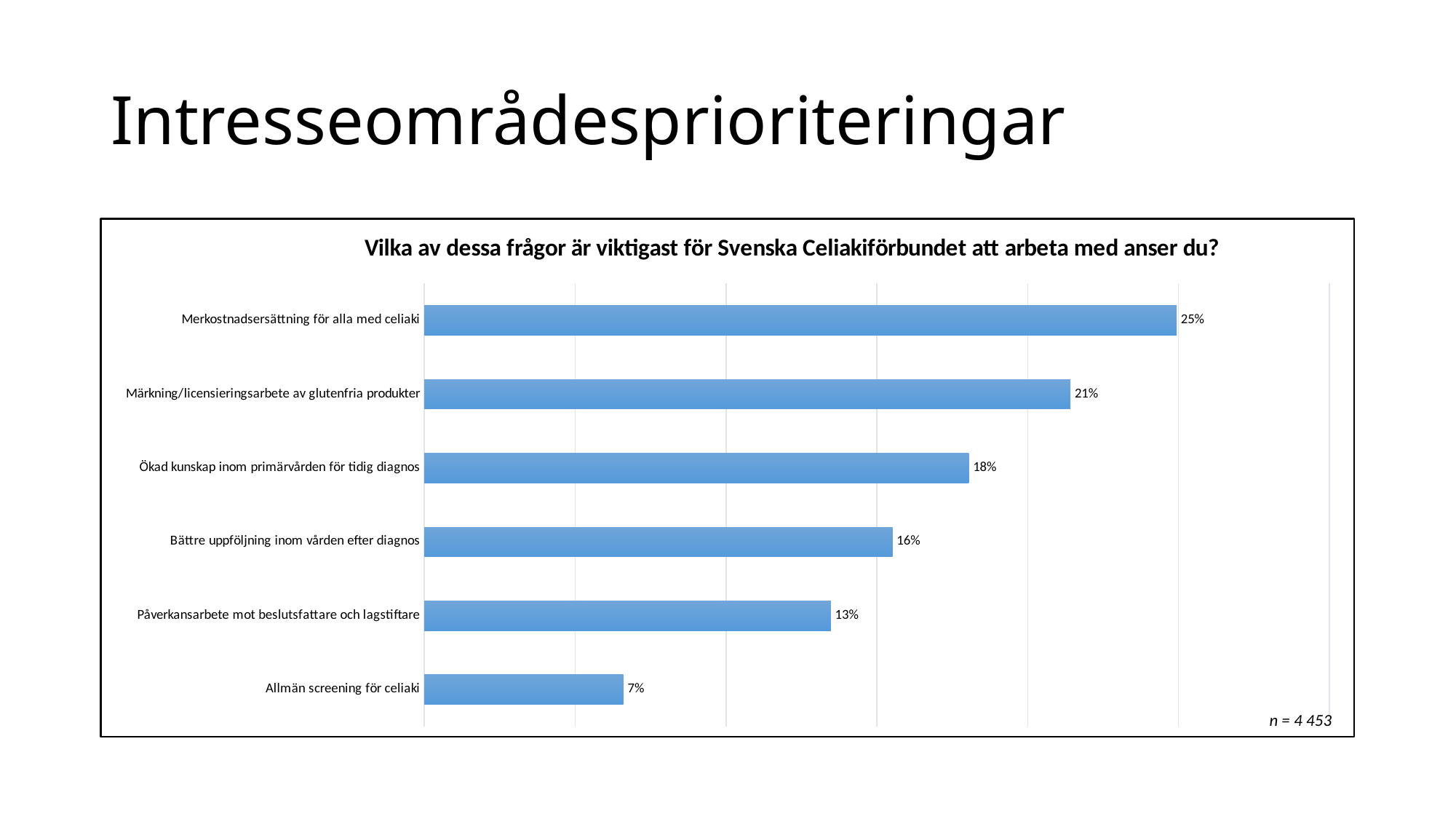
Which category has the lowest value? Allmän screening för celiaki What sample size (n) is noted on the chart? n = 4 453 What value is shown for "Allmän screening för celiaki"? 7% What is the chart's title? Vilka av dessa frågor är viktigast för Svenska Celiakiförbundet att arbeta med anser du? What is the difference between the highest and lowest values in the chart? 18% What percentage is shown for "Bättre uppföljning inom vården efter diagnos"? 16% What percentage is shown for "Merkostnadsersättning för alla med celiaki"? 25% Which is larger: "Ökad kunskap inom primärvården för tidig diagnos" or "Bättre uppföljning inom vården efter diagnos"? Ökad kunskap inom primärvården för tidig diagnos Which category has the highest value? Merkostnadsersättning för alla med celiaki How many categories are shown in the chart? 6 What kind of chart is shown on the slide? Bar chart What is the difference between "Märkning/licensieringsarbete av glutenfria produkter" and "Påverkansarbete mot beslutsfattare och lagstiftare"? 8%